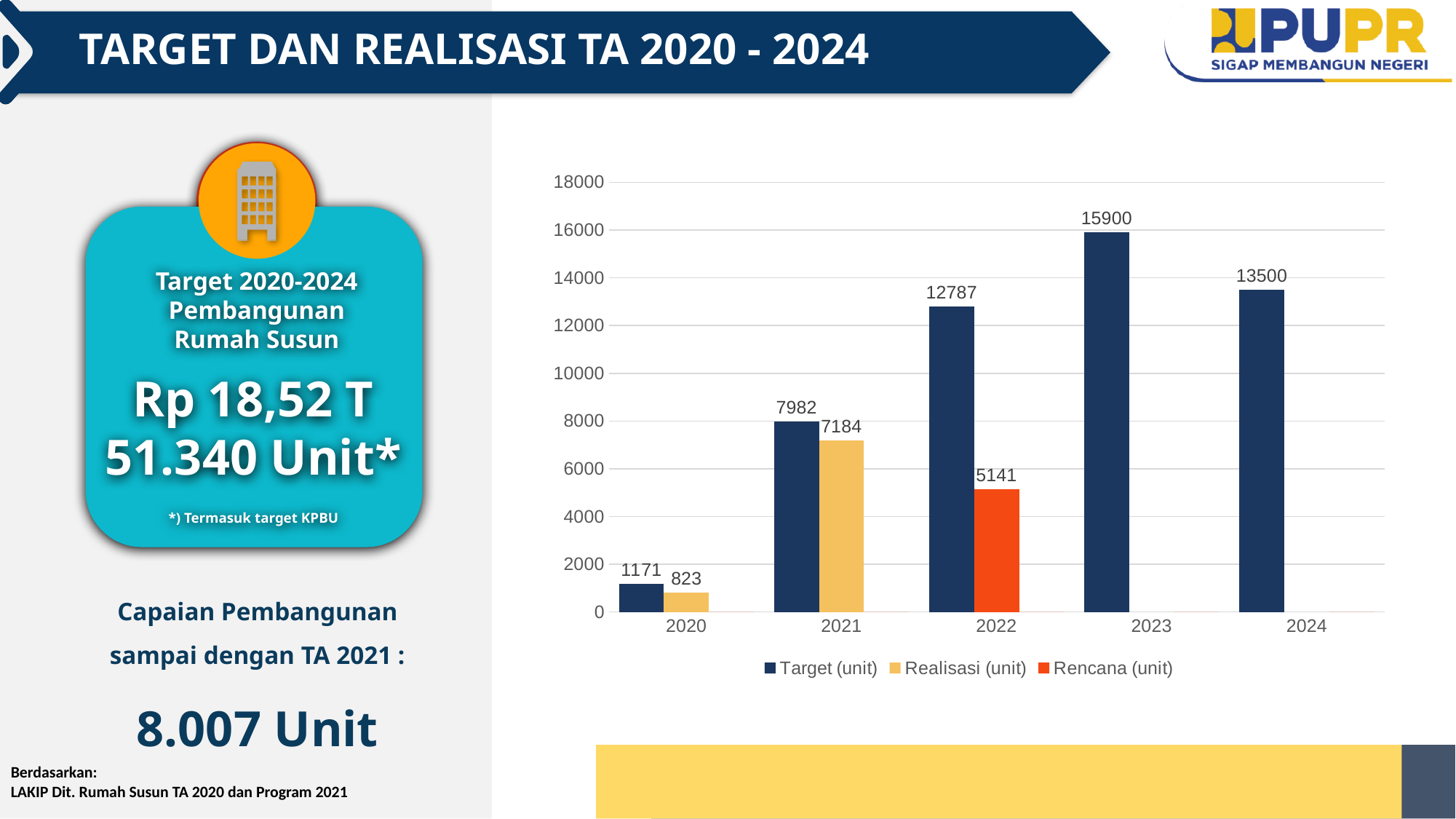
What kind of chart is shown on the slide? Bar chart Which is larger, the Target (unit) value for 2022 or the Target (unit) value for 2024? Target (unit) for 2024 What is the difference between the Target (unit) and Realisasi (unit) values for 2021? 798 Which year has the lowest Target (unit) value? 2020 What is the Rencana (unit) value for 2022? 5141 Which year has the highest Target (unit) value? 2023 What colour are the Rencana (unit) bars in the chart? Orange-red How many years are shown on the x axis of the chart? 5 What is the Target (unit) value for 2023? 15900 What is the Realisasi (unit) value for 2021? 7184 Is the Target (unit) value for 2022 greater or less than 12000? greater How many series does the chart legend list? 3